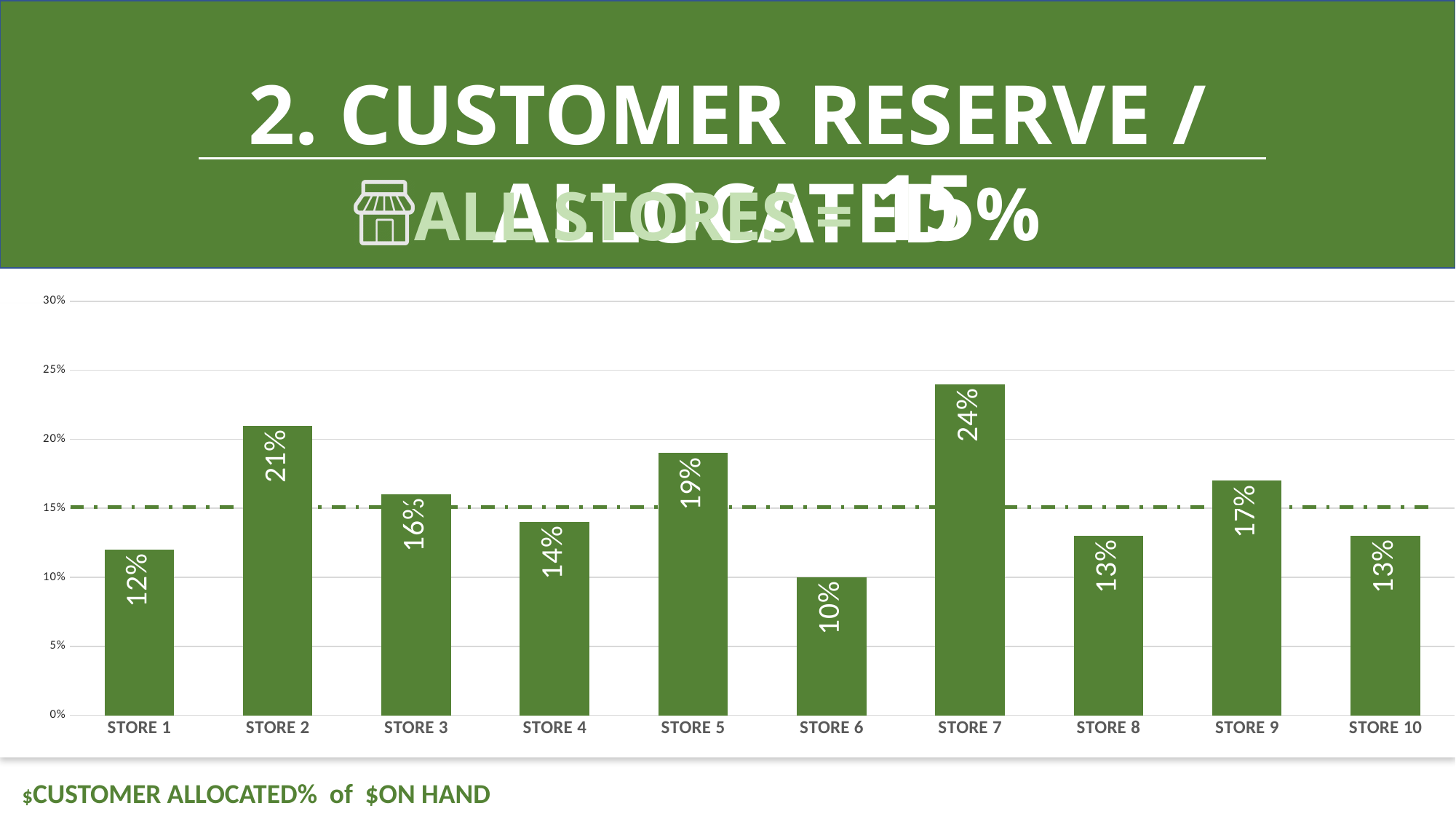
What is the value for STORE 7? 24% What value does the dashed horizontal line on the chart mark? 15% What is the difference between the values for STORE 7 and STORE 6? 14% Is the value for STORE 4 greater or less than 15%? less Which is larger, the value for STORE 5 or the value for STORE 9? STORE 5 Which store has the highest value? STORE 7 What is the value for STORE 10? 13% What is the difference between the values for STORE 2 and STORE 1? 9% What kind of chart is shown on the slide? bar chart Which store has the lowest value? STORE 6 How many stores are shown on the chart? 10 What is the value for STORE 3? 16%